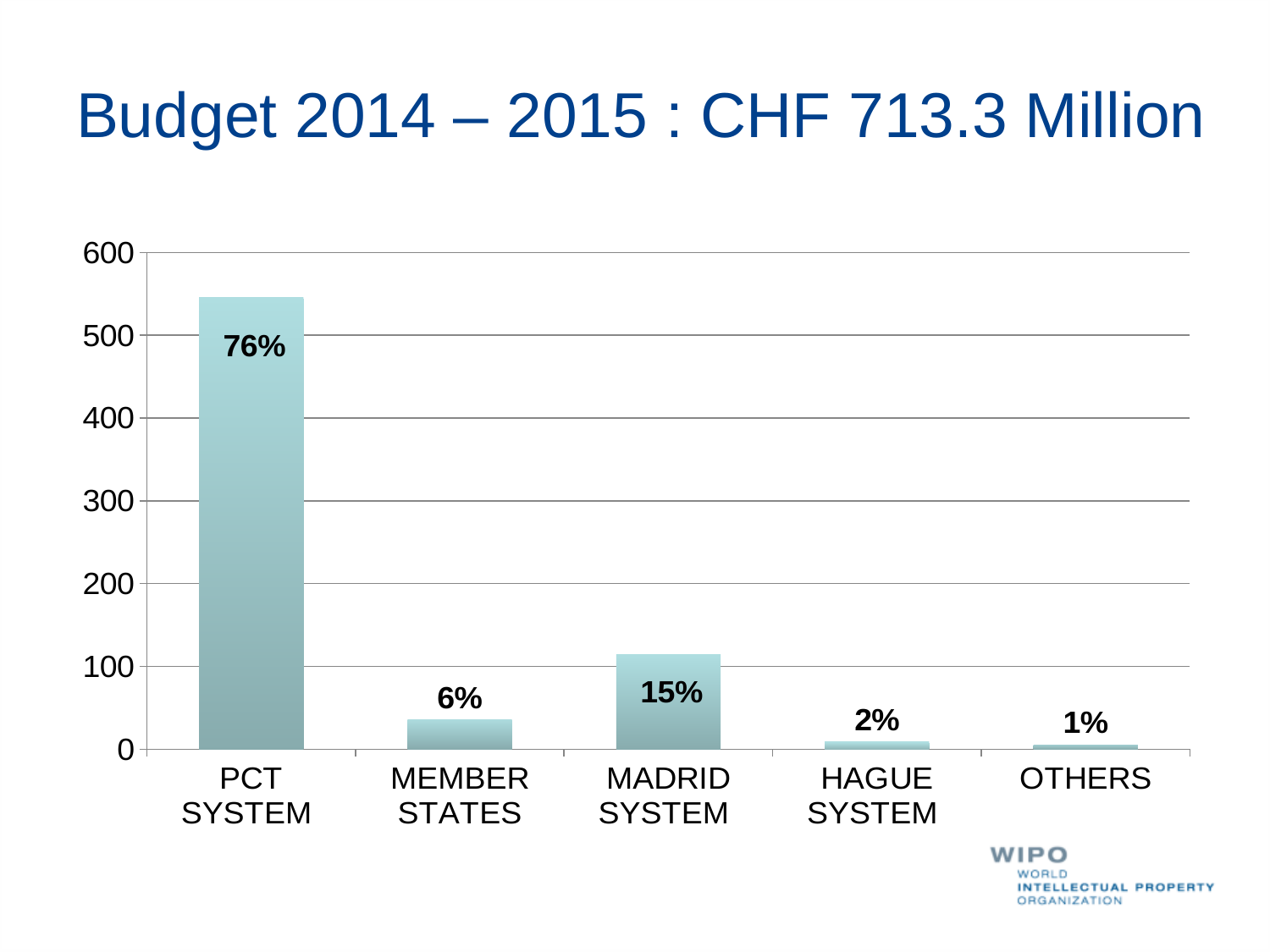
Which category has the lowest bar? OTHERS What percentage label is shown on the MADRID SYSTEM bar? 15% What is the title of the slide containing the chart? Budget 2014 – 2015 : CHF 713.3 Million Is the value for MEMBER STATES greater or less than 100? less Which category has the highest bar? PCT SYSTEM What kind of chart is shown on the slide? Bar chart How many categories are shown on the x axis? 5 What percentage label is shown on the HAGUE SYSTEM bar? 2% What percentage label is shown on the MEMBER STATES bar? 6% Is the value for PCT SYSTEM greater or less than 500? greater What percentage label is shown on the PCT SYSTEM bar? 76% Which is larger, the bar for MADRID SYSTEM or the bar for MEMBER STATES? MADRID SYSTEM